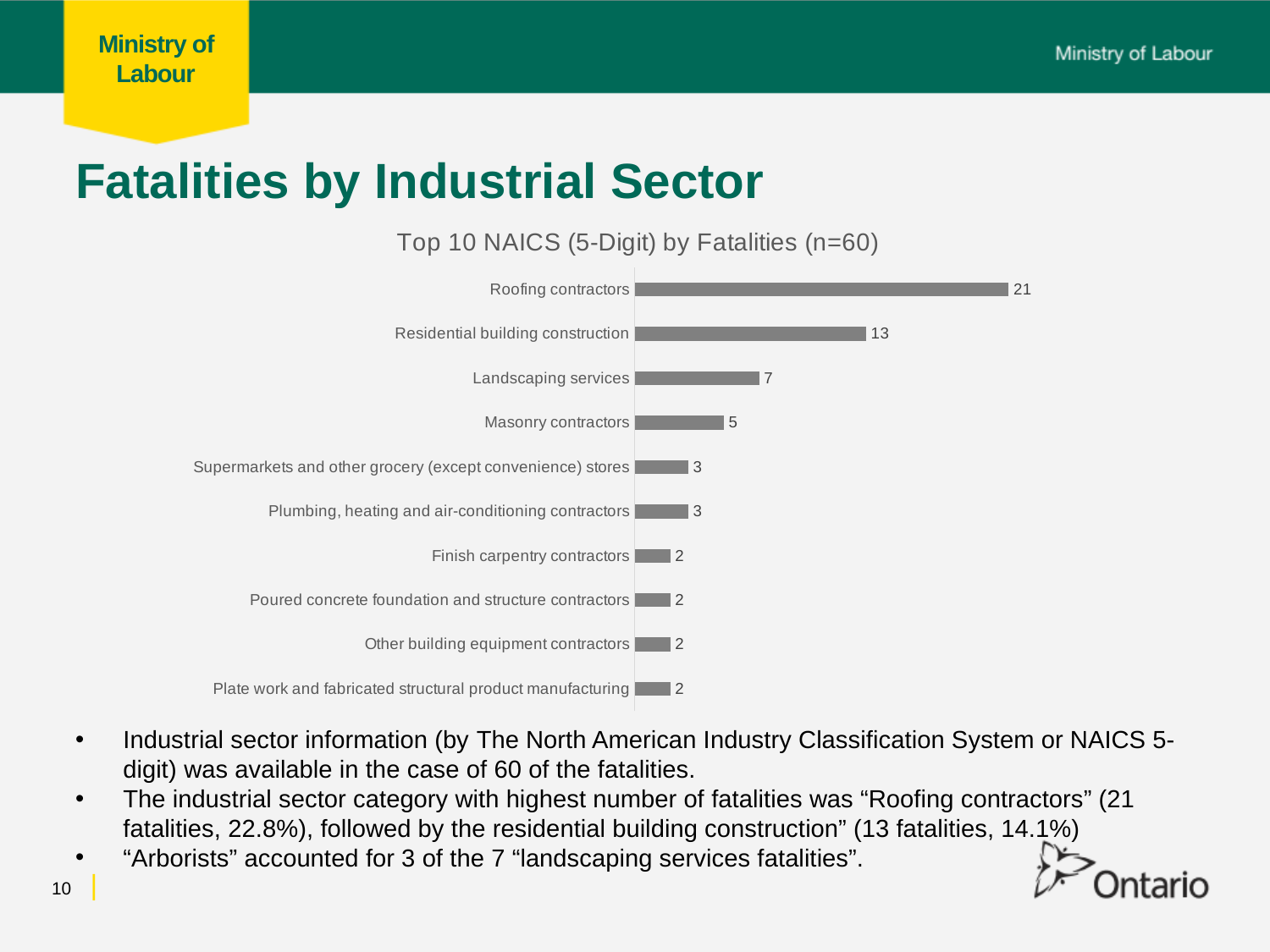
What is the value for Landscaping services? 7 How many categories are shown in the chart? 10 Which category has the highest number of fatalities? Roofing contractors What is the title of the chart? Top 10 NAICS (5-Digit) by Fatalities (n=60) What is the value for Masonry contractors? 5 What is the difference between Landscaping services and Masonry contractors? 2 What is the value for Roofing contractors? 21 Which is larger, Masonry contractors or Plumbing, heating and air-conditioning contractors? Masonry contractors What is the value for Supermarkets and other grocery (except convenience) stores? 3 What kind of chart is shown on the slide? Bar chart What is the value for Residential building construction? 13 What is the difference between Roofing contractors and Residential building construction? 8